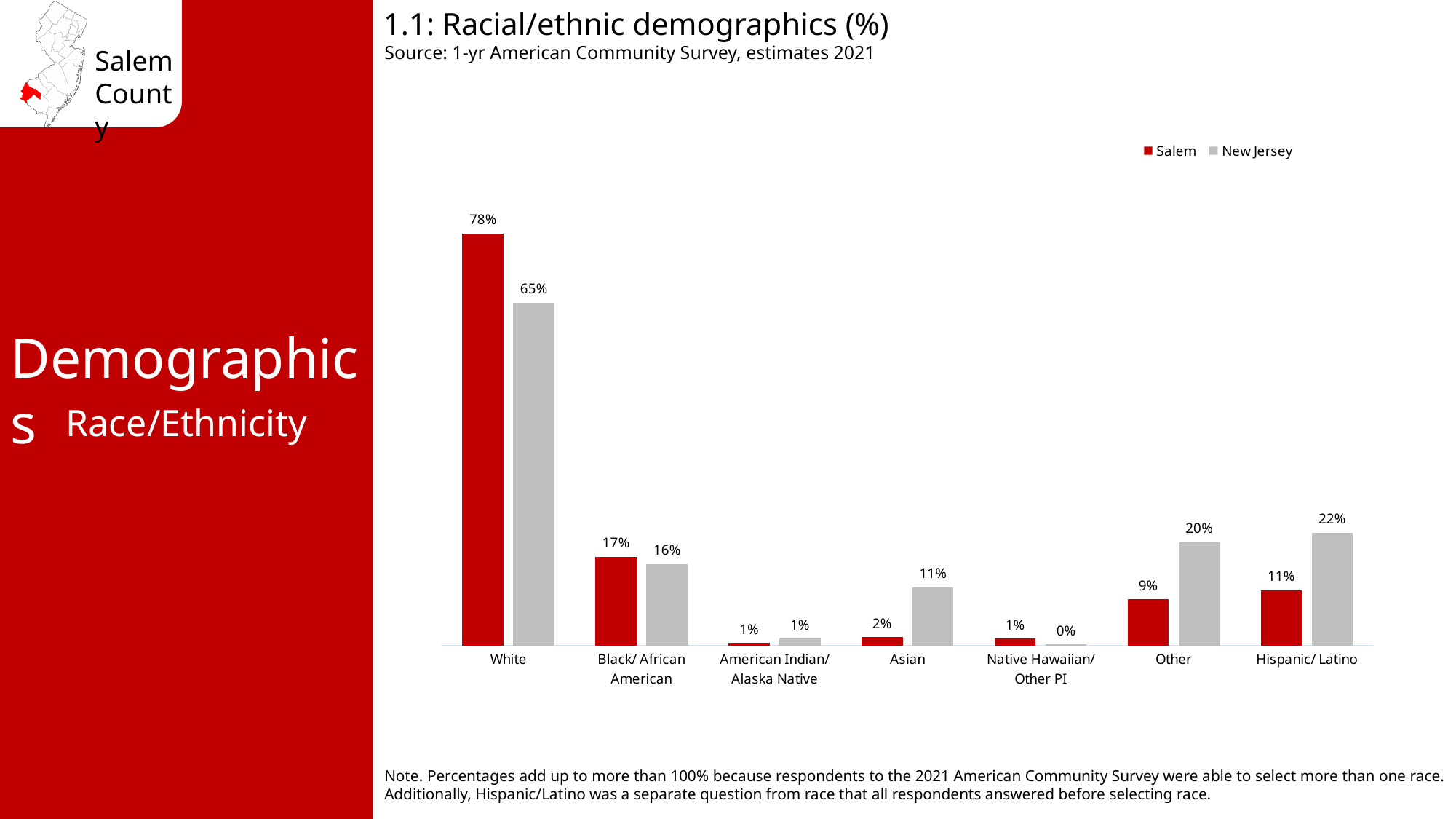
What is the New Jersey value for Asian? 11% How many series does the legend list? 2 What is the Salem value for White? 78% Which is larger for Asian, the Salem value or the New Jersey value? New Jersey What is the New Jersey value for Hispanic/ Latino? 22% Which category has the lowest New Jersey value? Native Hawaiian/ Other PI What is the difference between the Salem and New Jersey values for White? 13% Which category has the highest Salem value? White How many categories are shown on the x axis? 7 What kind of chart is shown on the slide? Bar chart What is the Salem value for Other? 9% What is the difference between the New Jersey and Salem values for Other? 11%